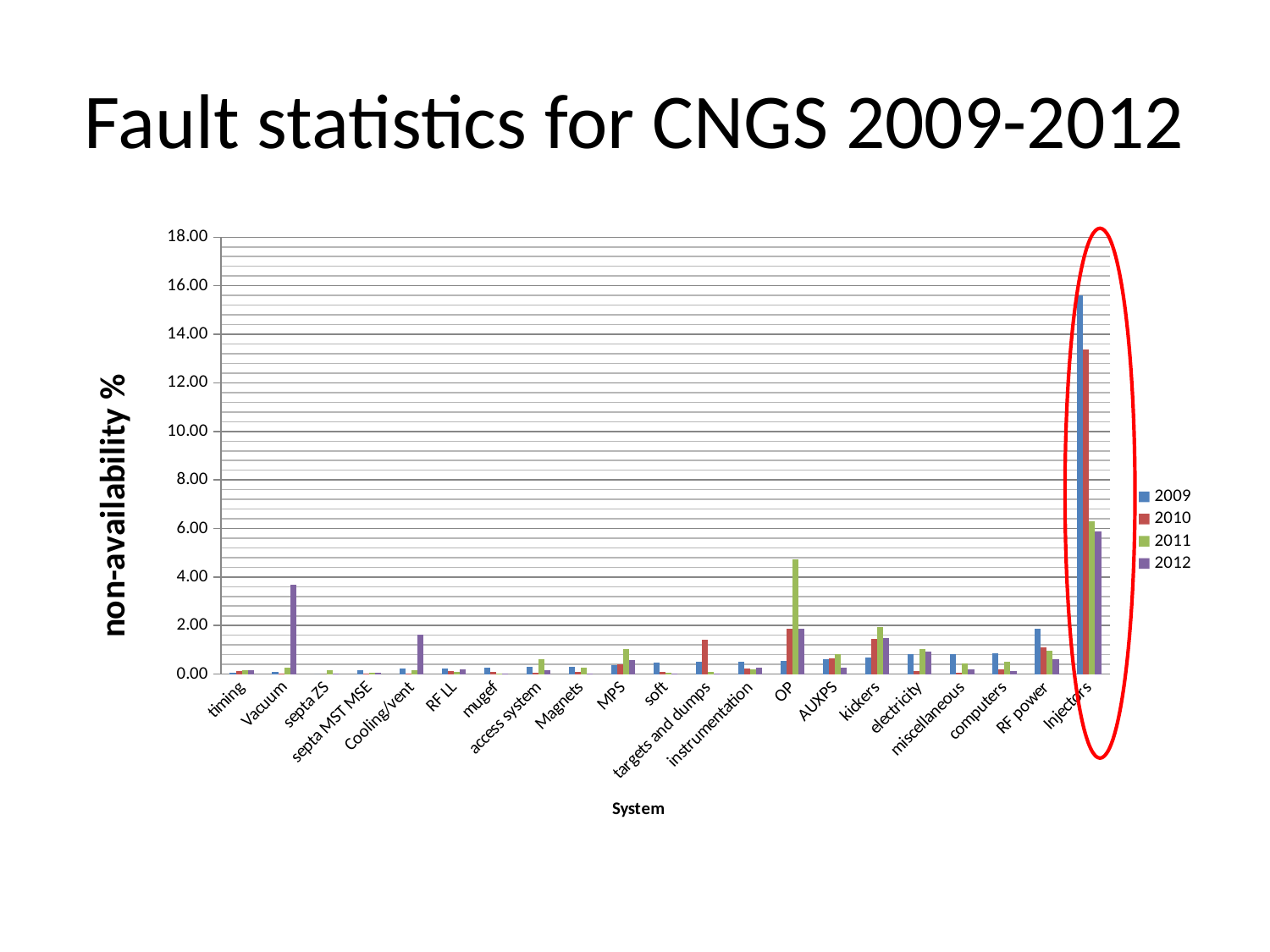
What is the title of the vertical axis? non-availability % Is the 2009 value for Injectors greater or less than 14.00? greater Which is larger for Injectors: the 2009 value or the 2010 value? 2009 How many series does the legend list? 4 For OP, which year has the highest non-availability? 2011 For Injectors, which year has the highest non-availability? 2009 Is the 2011 value for OP greater or less than 4.00? greater For Vacuum, which year has the highest non-availability? 2012 Is the 2012 value for Cooling/vent greater or less than 2.00? less What kind of chart is shown on the slide? bar chart How many system categories are shown on the x axis? 21